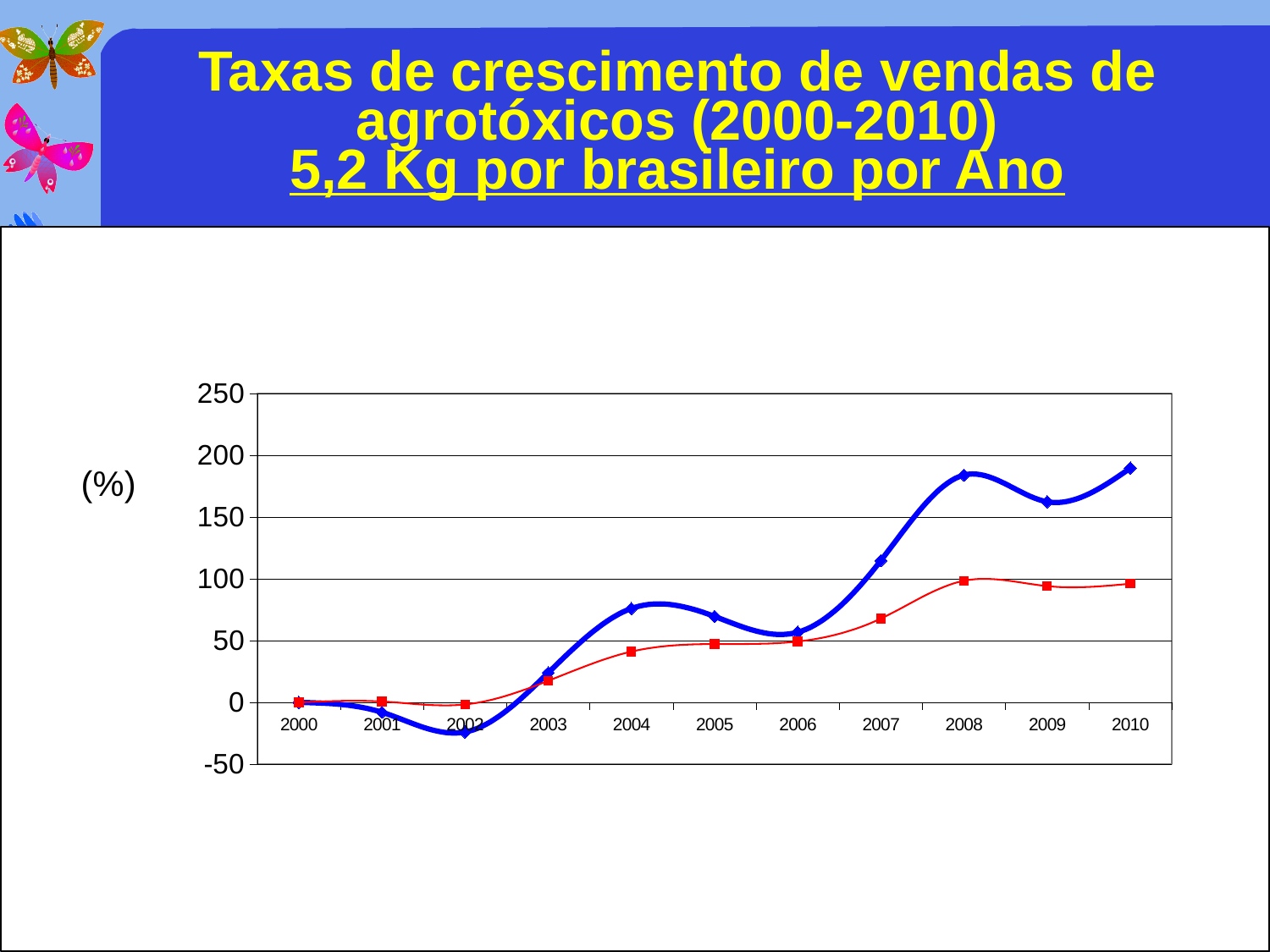
How many lines are plotted on the chart? 2 Is the value of the blue line for 2004 greater or less than 50? greater What kind of chart is shown on the slide? line chart What unit is shown next to the vertical axis? (%) Is the value of the blue line for 2002 greater or less than 0? less Is the value of the red line for 2007 greater or less than 50? greater In 2008, which line has the higher value, the blue line or the red line? the blue line In which year does the blue line reach its lowest value? 2002 How many years are plotted along the x axis? 11 Does the blue line rise or fall between 2006 and 2008? rise